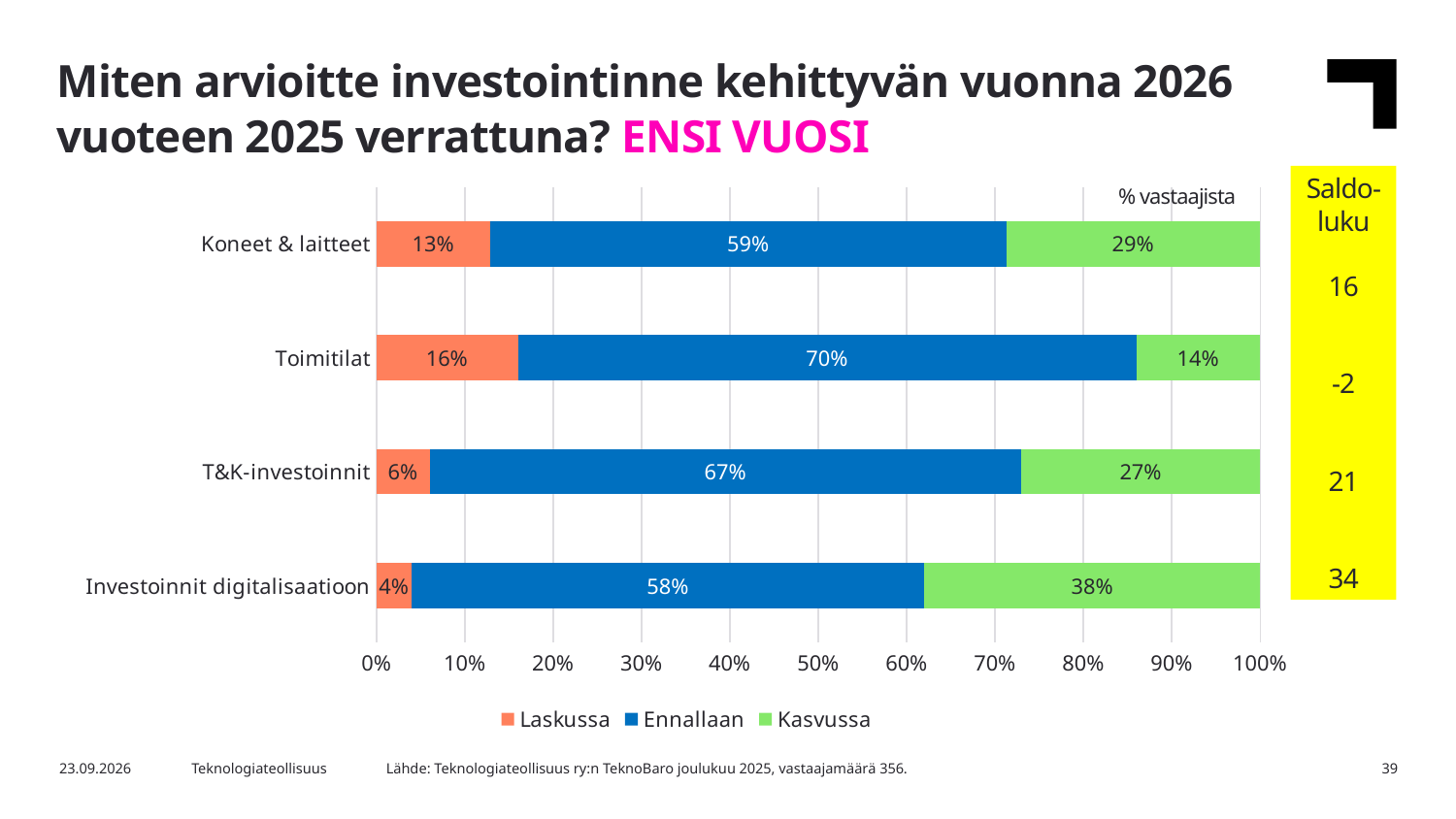
How many categories are shown on the chart? 4 What is the Kasvussa value for Investoinnit digitalisaatioon? 38% How many series does the legend list? 3 What percentage of respondents expect Koneet & laitteet investments to be Kasvussa? 29% Which category has the lowest Laskussa share? Investoinnit digitalisaatioon What kind of chart is shown on the slide? Stacked bar chart What is the Laskussa value for T&K-investoinnit? 6% Which is larger: the Kasvussa value for T&K-investoinnit or for Toimitilat? T&K-investoinnit What is the Ennallaan value for Toimitilat? 70% What is the Saldoluku value shown for T&K-investoinnit? 21 Which category has the highest Kasvussa share? Investoinnit digitalisaatioon What is the difference between the Ennallaan values for Toimitilat and Koneet & laitteet? 11 percentage points